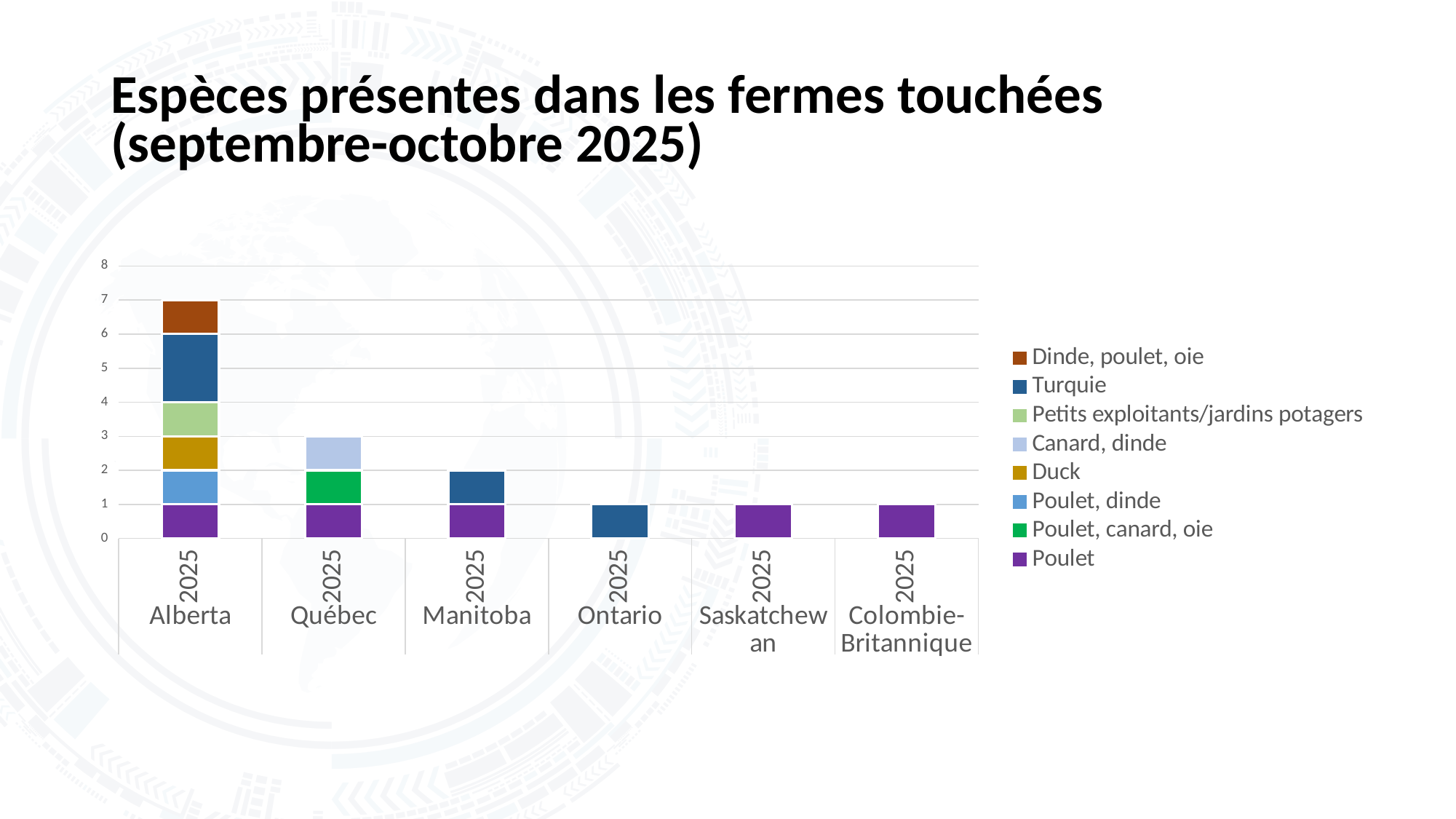
What is the total height of the stacked bar for Québec? 3 Is the total for Alberta greater or less than 5? greater How many series does the legend list? 8 What is the value of the Poulet segment for Saskatchewan? 1 What kind of chart is shown on the slide? Stacked bar chart What is the value of the Turquie segment for Alberta? 2 How many provinces are shown on the x axis of the chart? 6 What is the total height of the stacked bar for Alberta? 7 Which has a taller stacked bar, Manitoba or Ontario? Manitoba What is the difference between the total for Alberta and the total for Québec? 4 Which province has the tallest stacked bar? Alberta What is the title of the slide containing the chart? Espèces présentes dans les fermes touchées (septembre-octobre 2025)